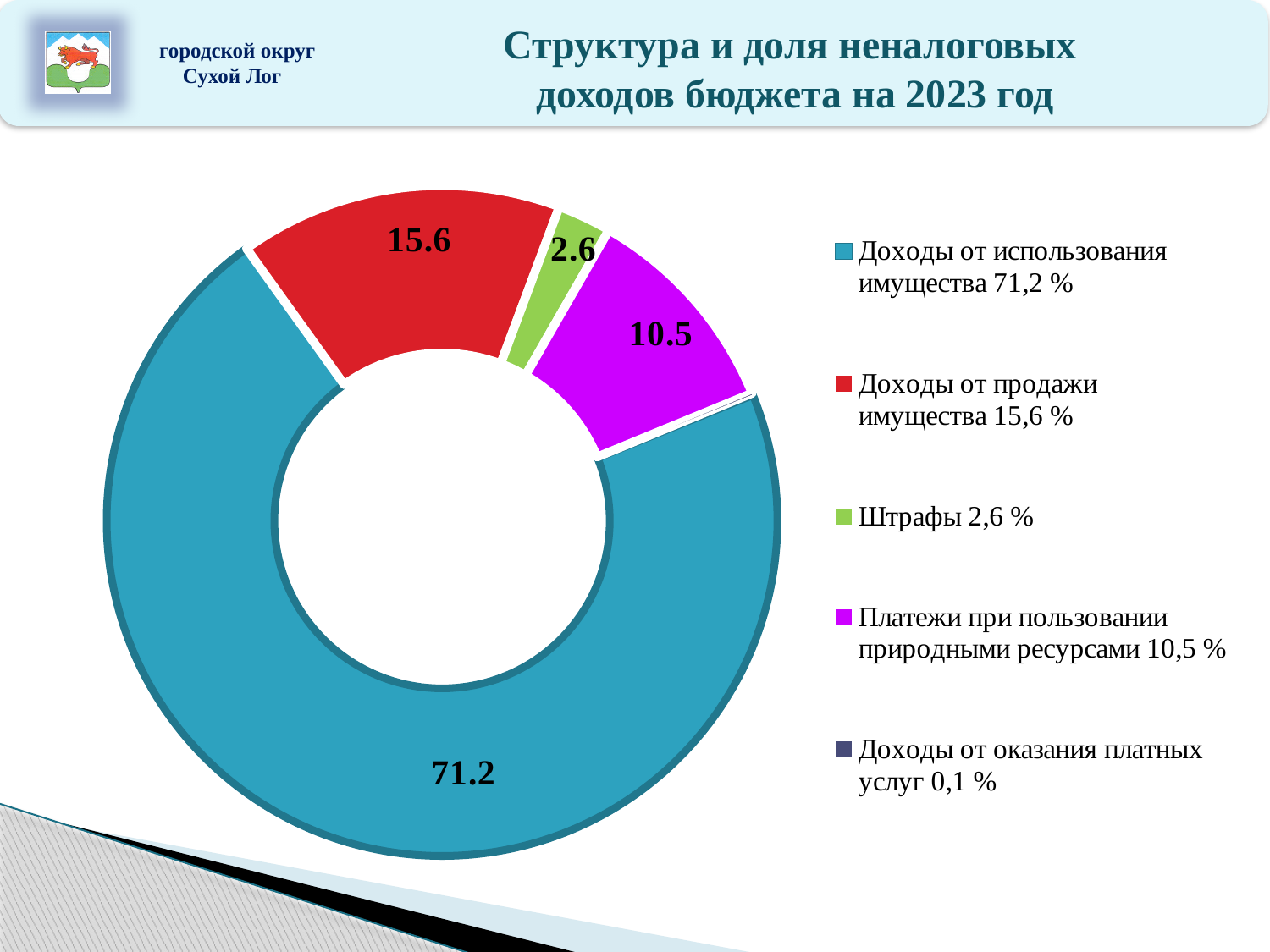
Which category has the smallest share according to the legend? Доходы от оказания платных услуг How many categories does the legend list? 5 What is the difference between the values for 'Доходы от использования имущества' and 'Доходы от продажи имущества'? 55.6 What is the difference between the values for 'Доходы от продажи имущества' and 'Платежи при пользовании природными ресурсами'? 5.1 What share of the chart does 'Платежи при пользовании природными ресурсами' take? 10.5 What colour is the slice for 'Штрафы'? green What value is shown for the slice 'Доходы от продажи имущества'? 15.6 Which is larger: the slice for 'Штрафы' or the slice for 'Платежи при пользовании природными ресурсами'? Платежи при пользовании природными ресурсами What value is shown for the slice 'Штрафы'? 2.6 Which category has the largest slice in the chart? Доходы от использования имущества What kind of chart is shown on the slide? doughnut chart What value is shown for the slice 'Доходы от использования имущества'? 71.2